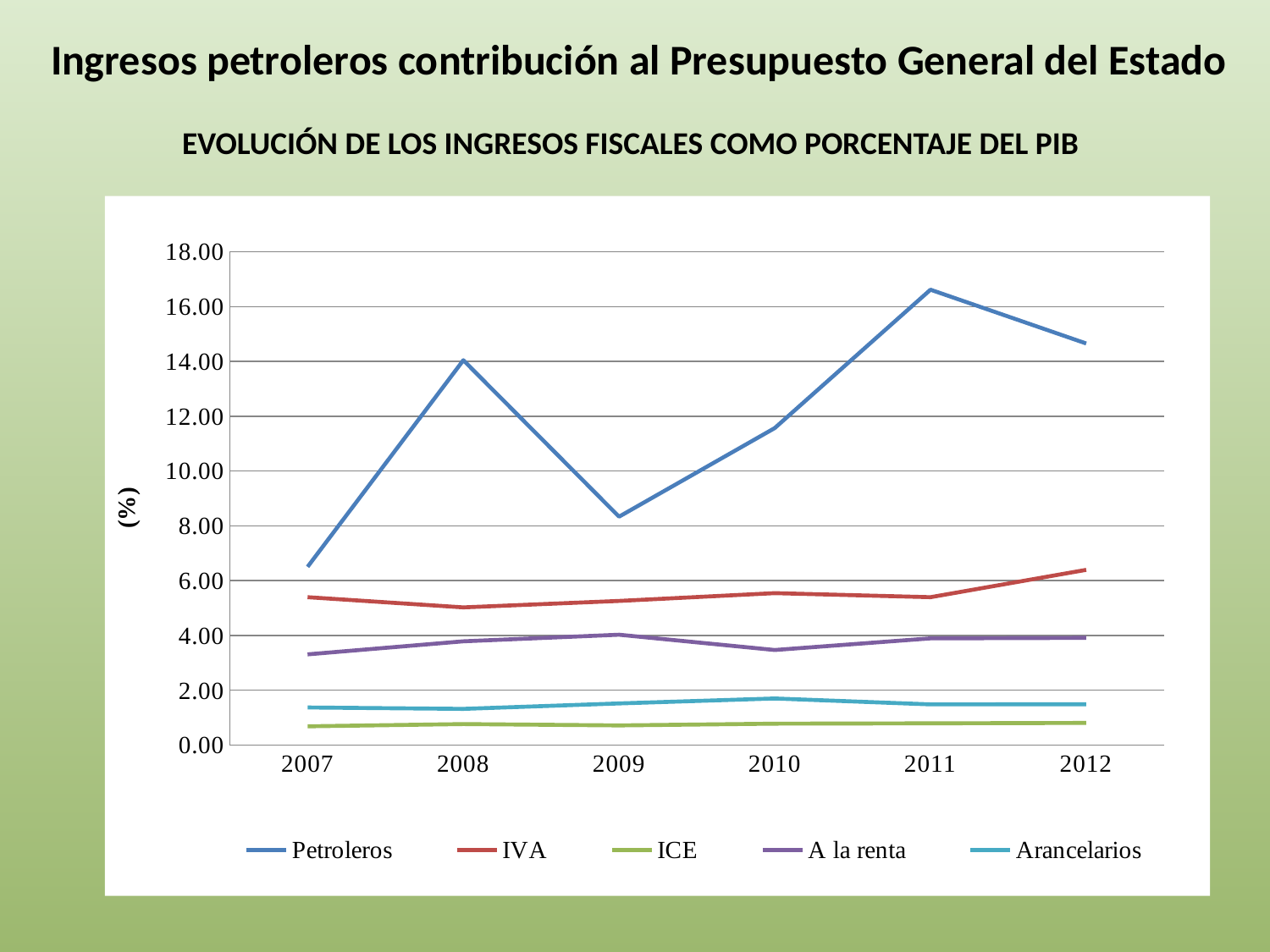
How many series does the legend list? 5 What kind of chart is shown on the slide? line chart In which year is the Petroleros series at its highest? 2011 Does the Petroleros series rise or fall from 2011 to 2012? fall Is the IVA value for 2012 greater or less than 6.00? greater How many years are shown on the x axis? 6 In which year is the Petroleros series at its lowest? 2007 Is the Petroleros value for 2011 greater or less than 16.00? greater In 2008, which is larger: Petroleros or IVA? Petroleros What is the label on the vertical axis? (%) Is the Petroleros value for 2009 greater or less than 10.00? less Which series has the lowest values throughout the chart? ICE